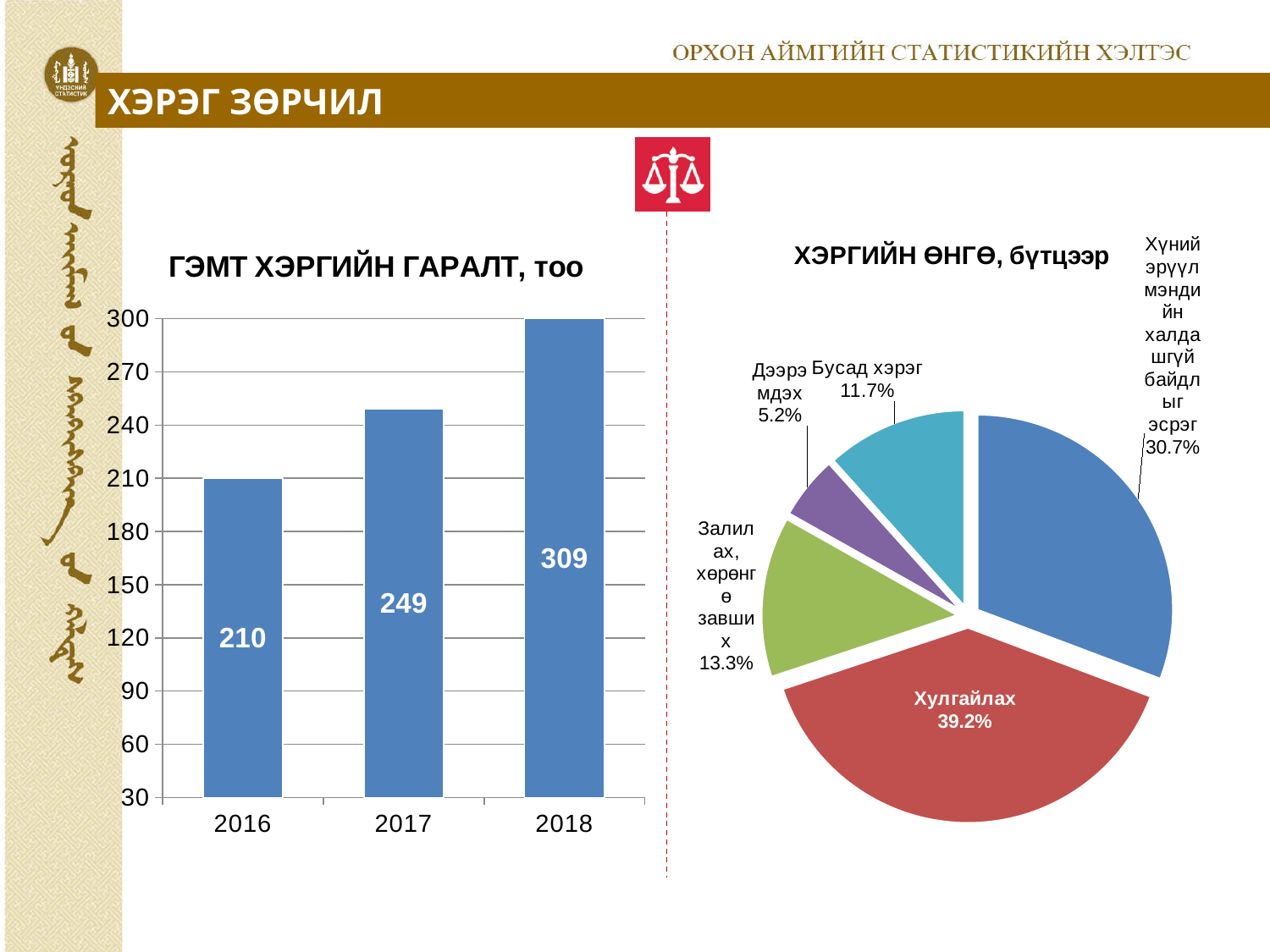
In the bar chart 'ГЭМТ ХЭРГИЙН ГАРАЛТ, тоо', what is the difference between the 2018 and 2016 values? 99 In the pie chart 'ХЭРГИЙН ӨНГӨ, бүтцээр', what share does 'Хулгайлах' have? 39.2% What type of chart is 'ГЭМТ ХЭРГИЙН ГАРАЛТ, тоо'? bar chart In the pie chart 'ХЭРГИЙН ӨНГӨ, бүтцээр', which is larger: 'Залилах, хөрөнгө завших' or 'Бусад хэрэг'? Залилах, хөрөнгө завших In the pie chart 'ХЭРГИЙН ӨНГӨ, бүтцээр', which category has the smallest share? Дээрэмдэх How many years are shown in the bar chart 'ГЭМТ ХЭРГИЙН ГАРАЛТ, тоо'? 3 In the bar chart 'ГЭМТ ХЭРГИЙН ГАРАЛТ, тоо', which year has the lowest value? 2016 In the bar chart 'ГЭМТ ХЭРГИЙН ГАРАЛТ, тоо', do the values rise or fall from 2016 to 2018? rise In the pie chart 'ХЭРГИЙН ӨНГӨ, бүтцээр', what is the share for 'Бусад хэрэг'? 11.7% In the bar chart 'ГЭМТ ХЭРГИЙН ГАРАЛТ, тоо', what is the value for 2017? 249 In the bar chart 'ГЭМТ ХЭРГИЙН ГАРАЛТ, тоо', what is the value for 2016? 210 In the bar chart 'ГЭМТ ХЭРГИЙН ГАРАЛТ, тоо', which year has the highest value? 2018